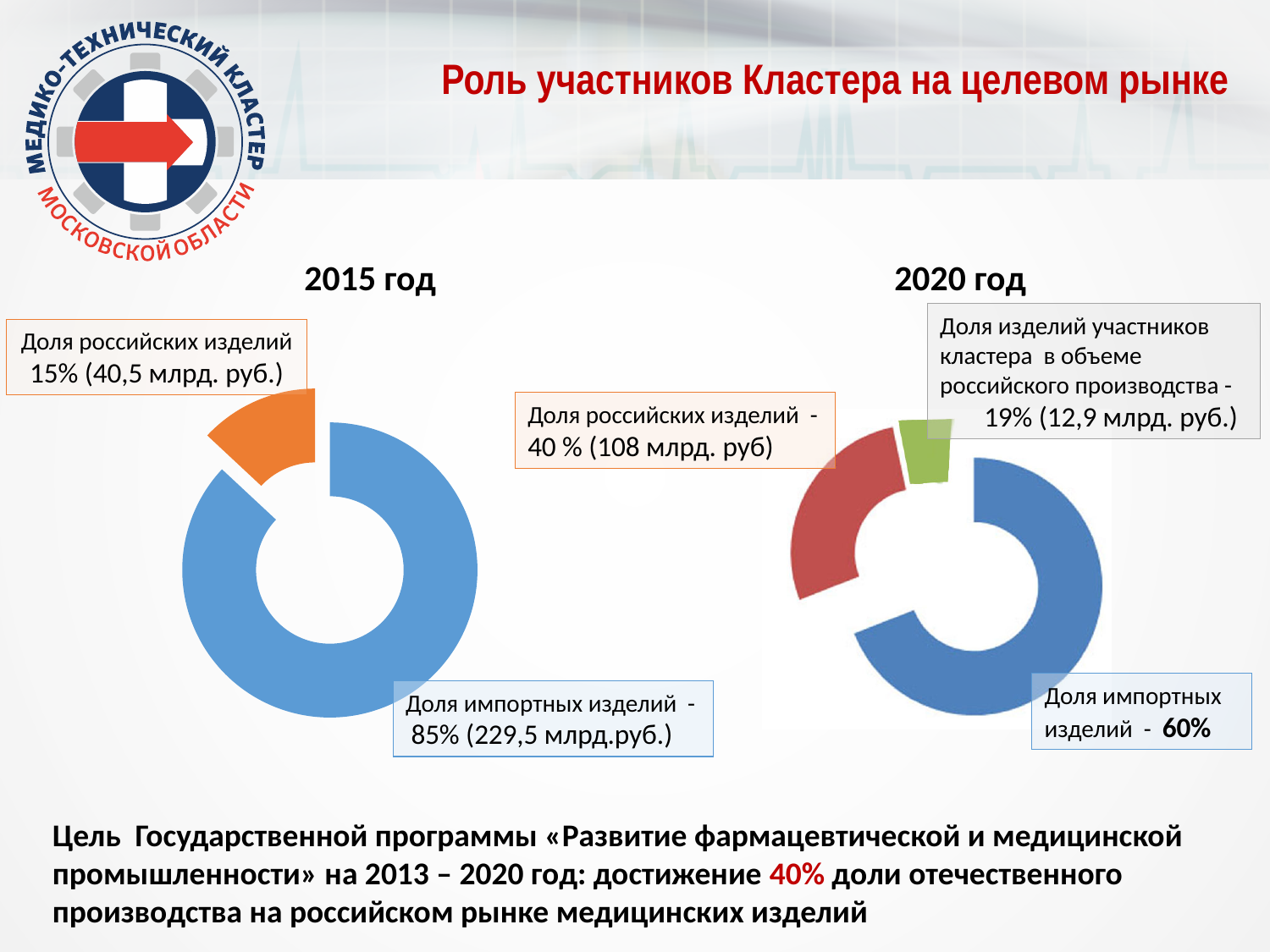
In the 2015 год chart, what is the share of imported products (Доля импортных изделий)? 85% By how many percentage points does the share of imported products exceed the share of Russian products in the 2015 год chart? 70 percentage points In the 2020 год chart, what is the share of imported products (Доля импортных изделий)? 60% What kind of chart is used for the 2015 год data? Donut (pie) chart In the 2015 год chart, what is the share of Russian products (Доля российских изделий)? 15% In the 2020 год chart, what is the share of Russian products (Доля российских изделий)? 40 % In the 2020 год chart, what is the ruble value given for Russian products? 108 млрд. руб In the 2020 год chart, what share of Russian production is attributed to cluster participants' products? 19% In the 2015 год chart, which segment is larger: Russian products or imported products? Imported products (Доля импортных изделий) In the 2015 год chart, what is the value in rubles given for Russian products? 40,5 млрд. руб. How many donut charts are shown on the slide? 2 In the 2015 год chart, what is the value in rubles given for imported products? 229,5 млрд.руб.